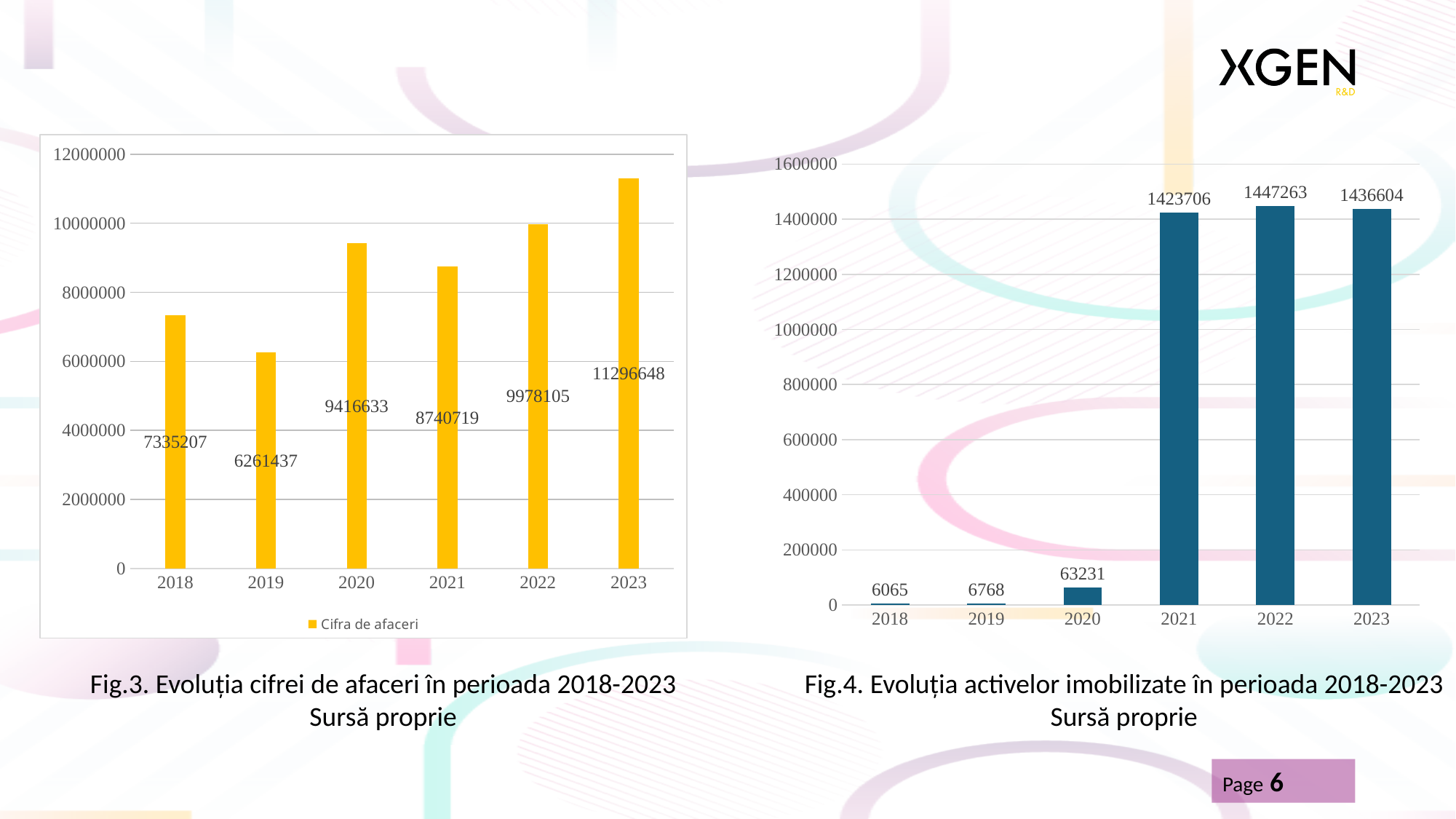
In the right chart (Fig.4), which year has the lowest value? 2018 In the left chart (Fig.3), what is the difference between the values for 2023 and 2022? 1318543 In the left chart (Fig.3), which year has the lowest value? 2019 In the right chart (Fig.4), what is the value for 2021? 1423706 In the left chart (Fig.3), which year has the highest value? 2023 How many years are shown on the x axis of the right chart (Fig.4)? 6 In the left chart (Fig.3), what is the value for 2020? 9416633 In the left chart (Fig.3), what series name does the legend show? Cifra de afaceri In the right chart (Fig.4), which year has the highest value? 2022 What type of chart is the right chart (Fig.4)? Bar chart In the right chart (Fig.4), what is the difference between the values for 2022 and 2023? 10659 In the left chart (Fig.3), which is larger, the value for 2021 or the value for 2022? 2022